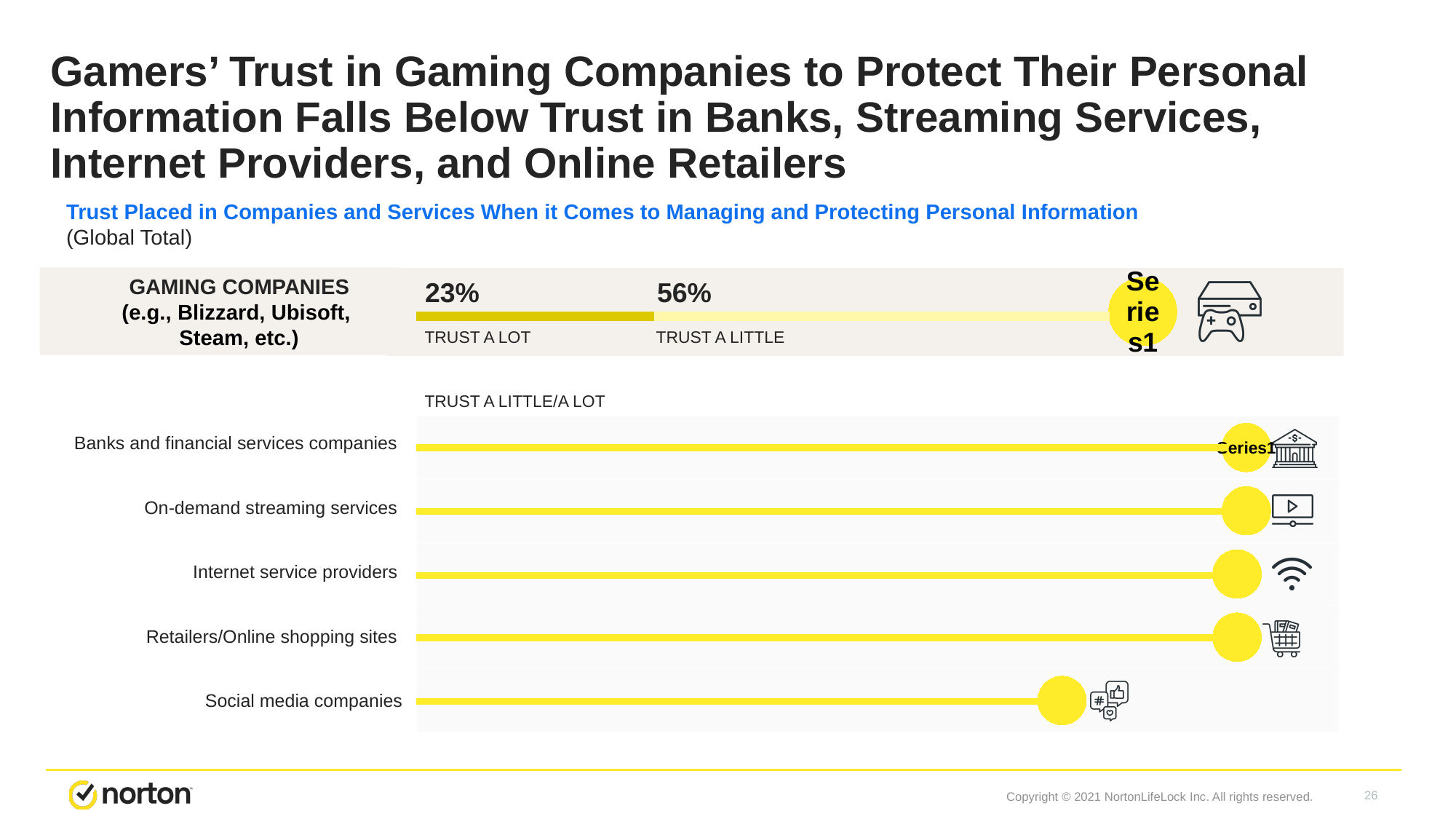
How many categories are plotted in the lower chart of other companies and services? 5 In the lower chart, which has a higher trust level: On-demand streaming services or Social media companies? On-demand streaming services In the gaming companies bar at the top, what percentage of gamers trust gaming companies a lot to protect their personal information? 23% In the gaming companies bar at the top, what is the difference between the 'trust a little' and 'trust a lot' percentages? 33 percentage points In the lower chart of other companies and services, which category has the highest level of trust (a little/a lot)? Banks and financial services companies and On-demand streaming services (tied) In the gaming companies bar at the top, what percentage of gamers trust gaming companies a little? 56% In the lower chart of other companies and services, which category has the lowest level of trust (a little/a lot)? Social media companies What is the title of the chart shown in blue on the slide? Trust Placed in Companies and Services When it Comes to Managing and Protecting Personal Information In the gaming companies bar at the top, which is larger: the share who trust a lot or the share who trust a little? Trust a little In the lower chart, which has a higher trust level: Banks and financial services companies or Social media companies? Banks and financial services companies In the gaming companies bar at the top, what is the combined share of gamers who trust gaming companies a lot or a little? 79% What kind of chart is used for the lower comparison of companies and services? Bar chart